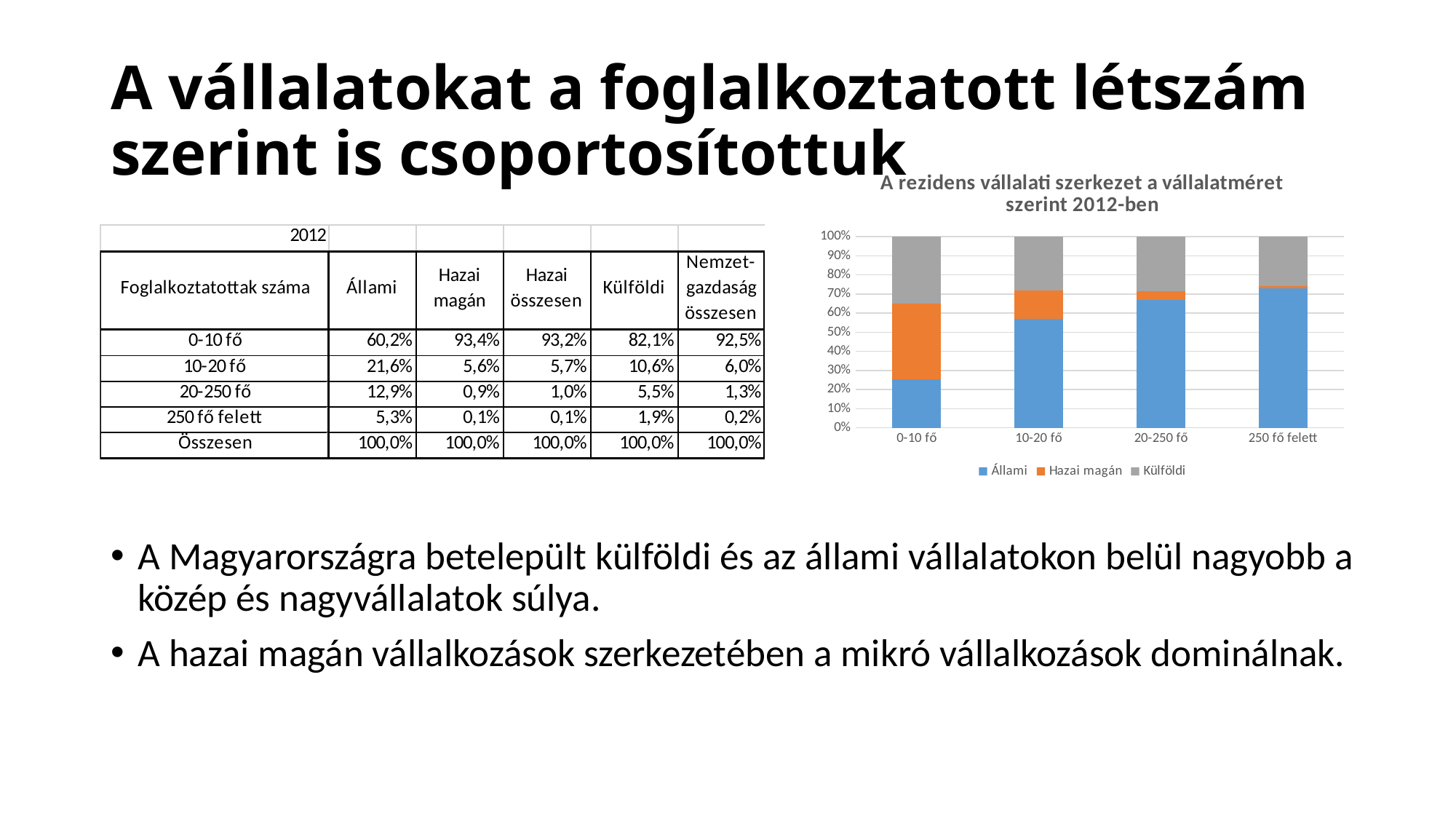
How many series does the chart's legend list? 3 Which category has the largest Állami share in the chart? 250 fő felett What is the title of the chart? A rezidens vállalati szerkezet a vállalatméret szerint 2012-ben Is the Állami share for the 10-20 fő category greater or less than 50%? greater Is the Állami share for the 250 fő felett category greater or less than 60%? greater Is the Állami share for the 20-250 fő category greater or less than 60%? greater Which category has the largest Hazai magán share in the chart? 0-10 fő Does the Állami share rise or fall as company size increases along the x axis? Rises How many company-size categories are shown on the x axis of the chart? 4 What kind of chart is shown on the slide? Stacked bar chart Which colour represents the Állami series in the chart? Blue